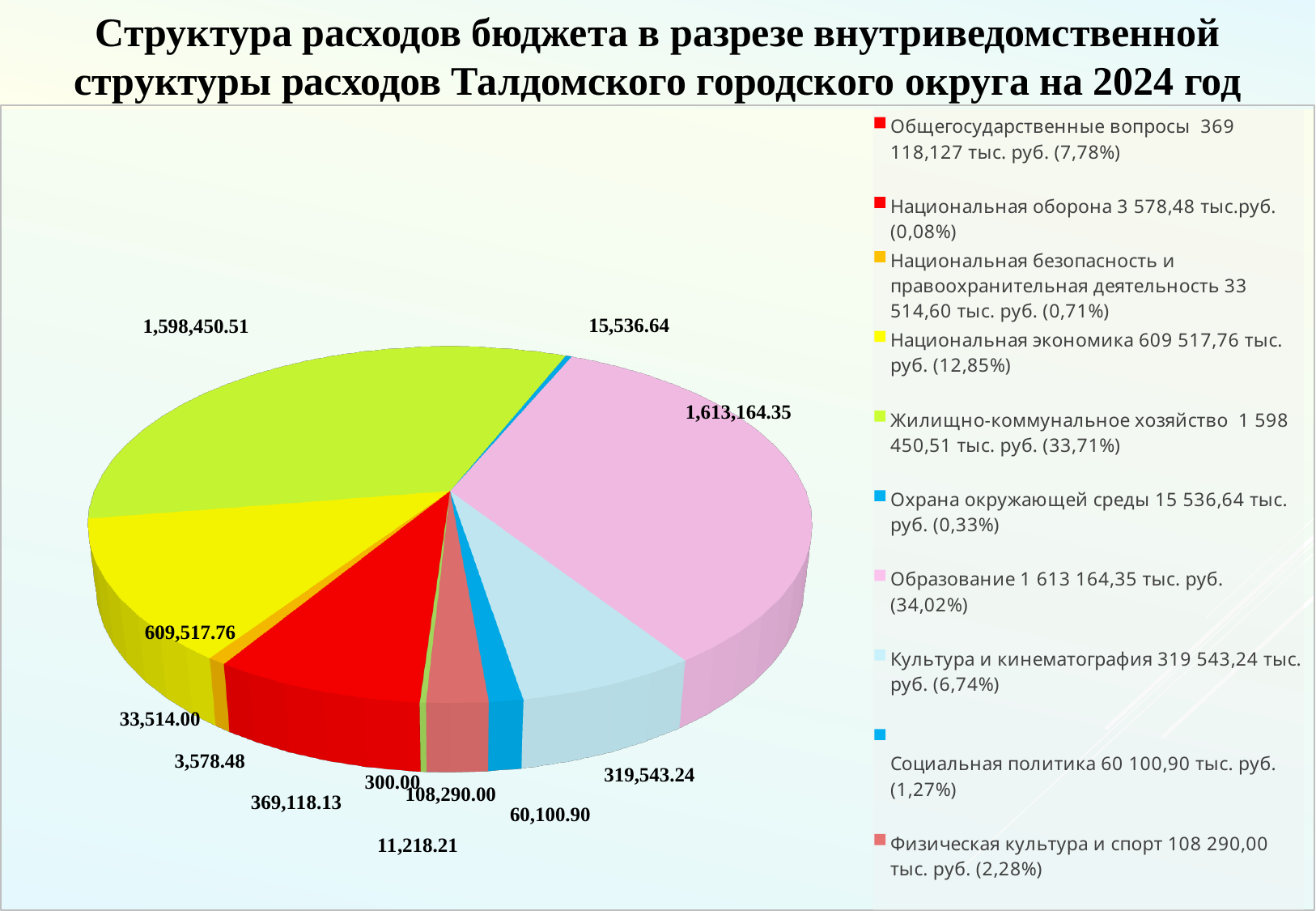
What is the value shown for Жилищно-коммунальное хозяйство? 1,598,450.51 What is the value shown for Социальная политика? 60,100.90 What is the value shown for Культура и кинематография? 319,543.24 How many categories are listed in the legend? 10 What is the value shown for Образование? 1,613,164.35 What is the difference between the values for Образование and Жилищно-коммунальное хозяйство? 14,713.84 Which category has the largest slice of the pie? Образование What kind of chart is shown on the slide? pie chart What is the value shown for Национальная экономика? 609,517.76 According to the legend, what share of the pie does Образование represent? 34,02% According to the legend, what share of the pie does Жилищно-коммунальное хозяйство represent? 33,71% Which is larger, the value for Образование or the value for Жилищно-коммунальное хозяйство? Образование